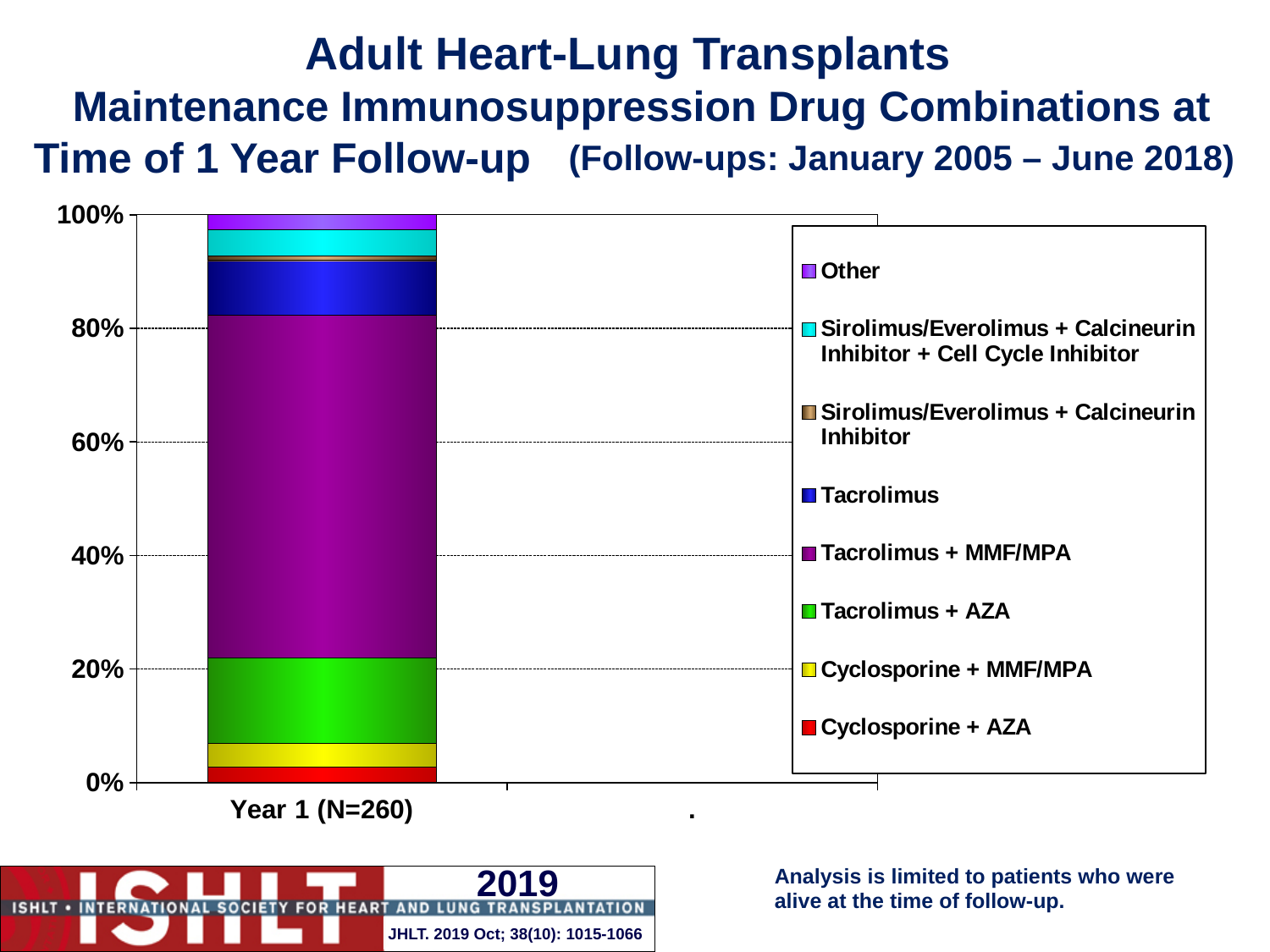
Which segment is larger in the Year 1 bar: Tacrolimus + MMF/MPA or Tacrolimus + AZA? Tacrolimus + MMF/MPA How many series does the legend list? 8 Which drug combination makes up the largest segment of the Year 1 bar? Tacrolimus + MMF/MPA Is the share for Tacrolimus + AZA greater or less than 20%? less How many patients (N) are included in the Year 1 bar? 260 Which segment is larger in the Year 1 bar: Tacrolimus + AZA or Tacrolimus? Tacrolimus + AZA How many bars are plotted in the chart? 1 Is the share for Tacrolimus + MMF/MPA greater or less than 40%? greater What kind of chart is shown on the slide? Stacked bar chart What colour represents Cyclosporine + AZA in the legend? Red What is the label of the single category on the x axis? Year 1 (N=260) What value does the top of the stacked Year 1 bar reach on the y axis? 100%